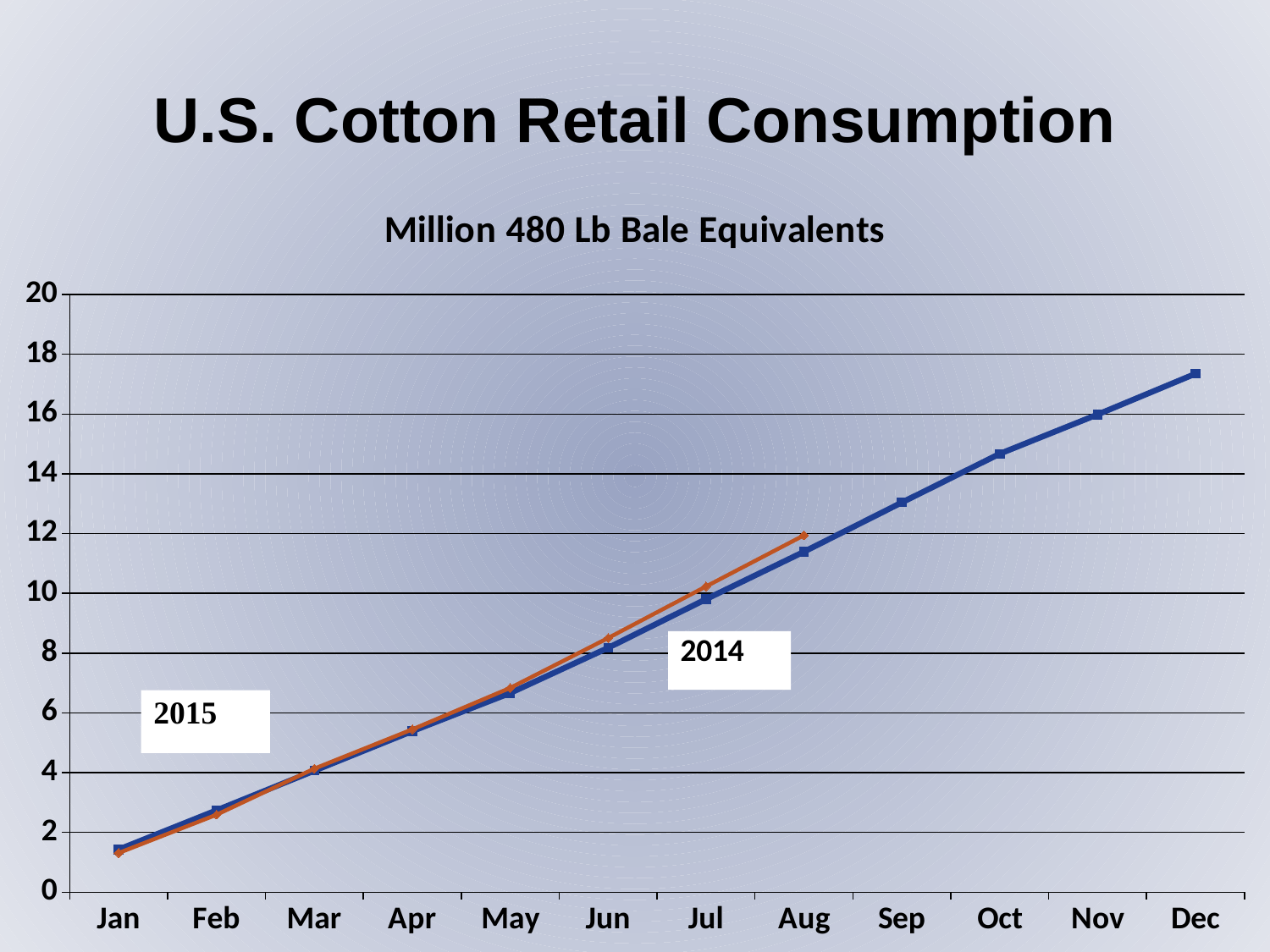
What kind of chart is shown on the slide? line chart Is the value for 2015 in Aug greater or less than 10? greater Which two years are labelled on the chart? 2014 and 2015 In which month is the 2014 series at its lowest value? Jan How many months are shown along the x axis? 12 Is the value for 2014 in Oct greater or less than 16? less What is the last month for which the 2015 series has a data point? Aug Is the value for 2014 in Dec greater or less than 16? greater How many data series are plotted on the chart? 2 In which month does the 2014 series reach its highest value? Dec Do the values for the 2014 series rise or fall from Jan to Dec? rise What unit is given in the chart subtitle? Million 480 Lb Bale Equivalents